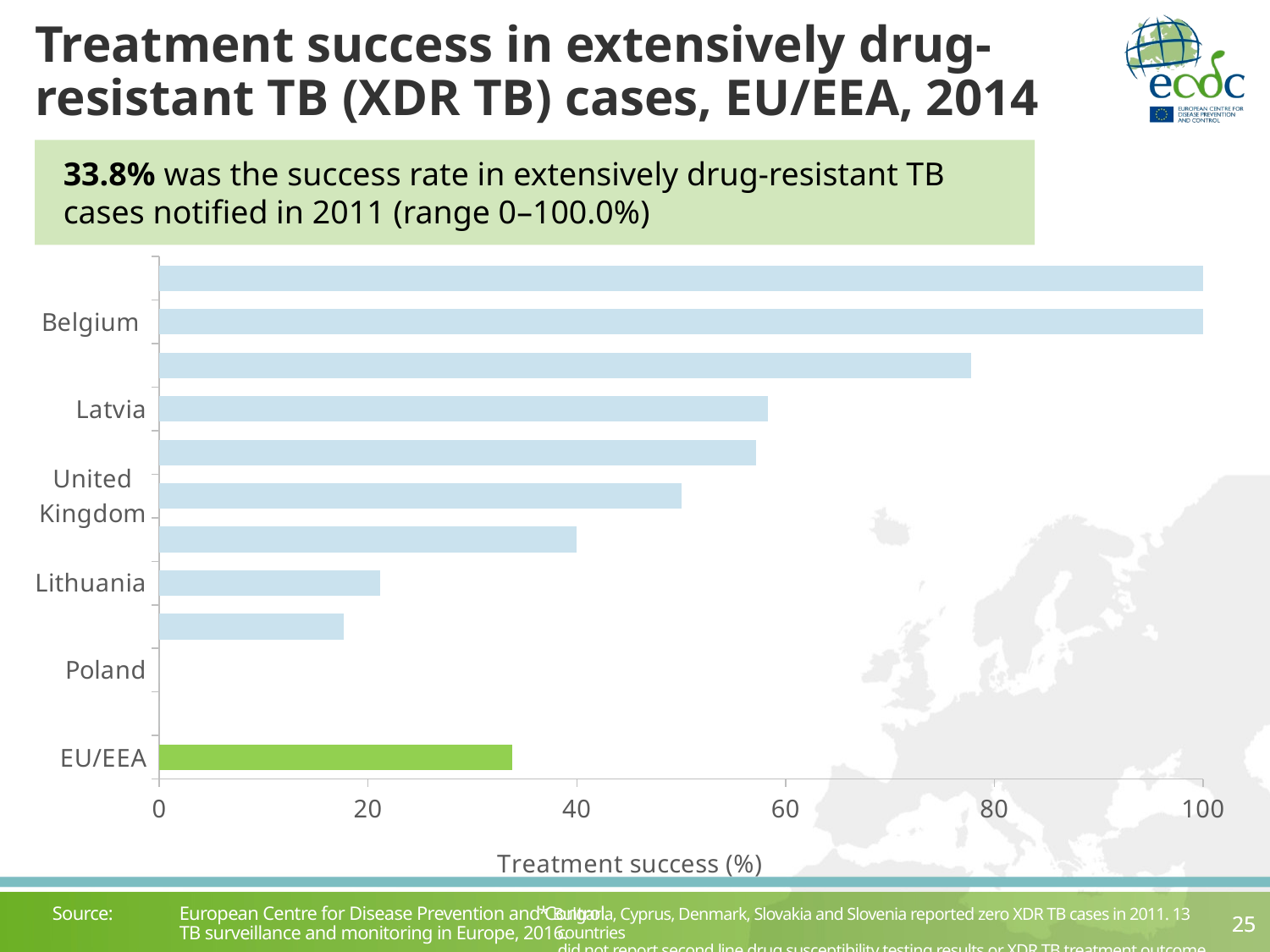
Is the treatment success value for United Kingdom greater or less than 60? less Is the treatment success value for Latvia greater or less than 40? greater What kind of chart is shown on the slide? bar chart Is the treatment success value for Lithuania greater or less than 40? less What is the treatment success rate for EU/EEA? 33.8% What is the treatment success (%) for Belgium? 100 Which has the higher treatment success, Belgium or Latvia? Belgium Which has the higher treatment success, Latvia or Lithuania? Latvia What is the treatment success (%) for Poland? 0 What is the difference in treatment success (%) between Belgium and Poland? 100 Which labelled country has the lowest treatment success? Poland What is the title of the x axis? Treatment success (%)